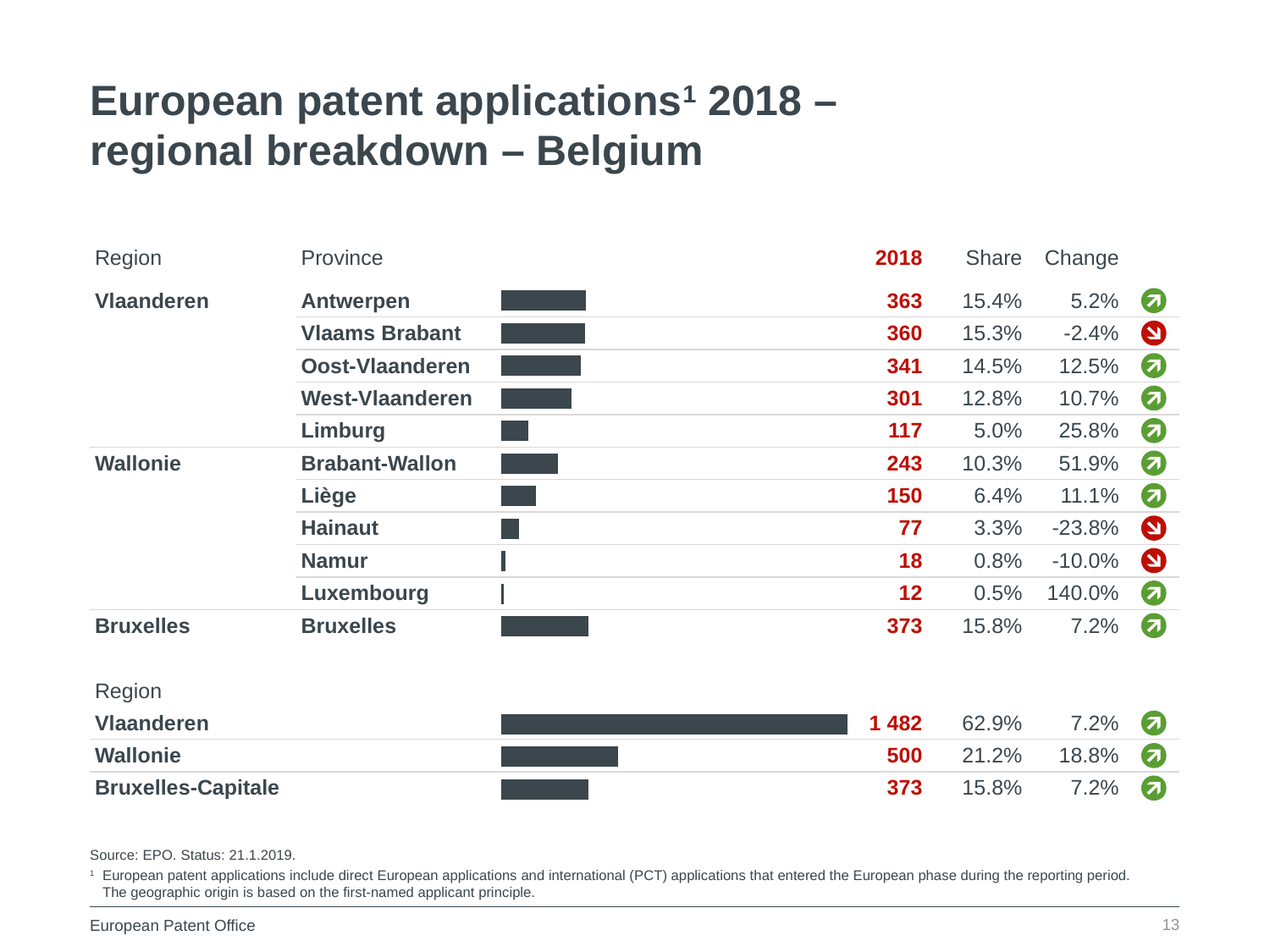
In the region-level chart, which region has the lowest 2018 value? Bruxelles-Capitale In the region-level chart, what share does Wallonie have? 21.2% How many provinces are shown in the province-level chart? 11 In the province-level chart, what is the difference between the 2018 values for Antwerpen and Limburg? 246 In the region-level chart, what is the 2018 value for Vlaanderen? 1 482 In the province-level chart, which province has the lowest 2018 value? Luxembourg In the province-level chart, which has a larger 2018 value, Liège or Hainaut? Liège In the province-level chart, how many European patent applications did Antwerpen have in 2018? 363 In the province-level chart, which province has the highest 2018 value? Bruxelles In the region-level chart, what is the difference between the 2018 values for Wallonie and Bruxelles-Capitale? 127 What kind of chart is used to show the 2018 values on this slide? Bar chart In the province-level chart, what is the 2018 value for Brabant-Wallon? 243